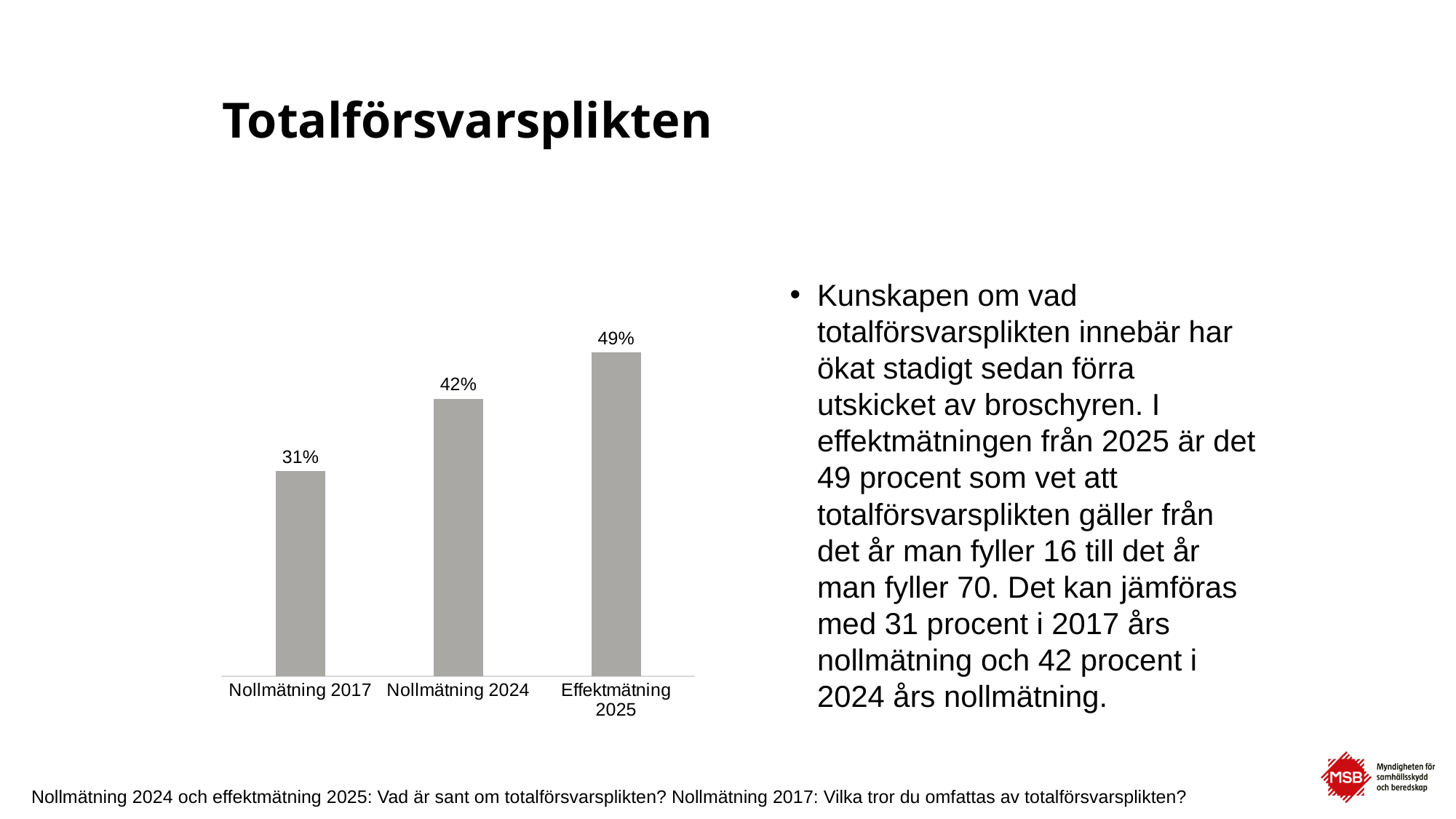
Which category has the highest value? Effektmätning 2025 Which category has the lowest value? Nollmätning 2017 What is the title of the slide containing the chart? Totalförsvarsplikten How many categories are shown in the chart? 3 What kind of chart is shown on the slide? Bar chart What is the difference between the values for Effektmätning 2025 and Nollmätning 2017? 18% What is the value for Nollmätning 2017? 31% Which is larger, the value for Nollmätning 2024 or the value for Effektmätning 2025? Effektmätning 2025 What is the difference between the values for Nollmätning 2024 and Nollmätning 2017? 11% Do the values rise or fall from Nollmätning 2017 to Effektmätning 2025? Rise What is the value for Nollmätning 2024? 42% What is the value for Effektmätning 2025? 49%